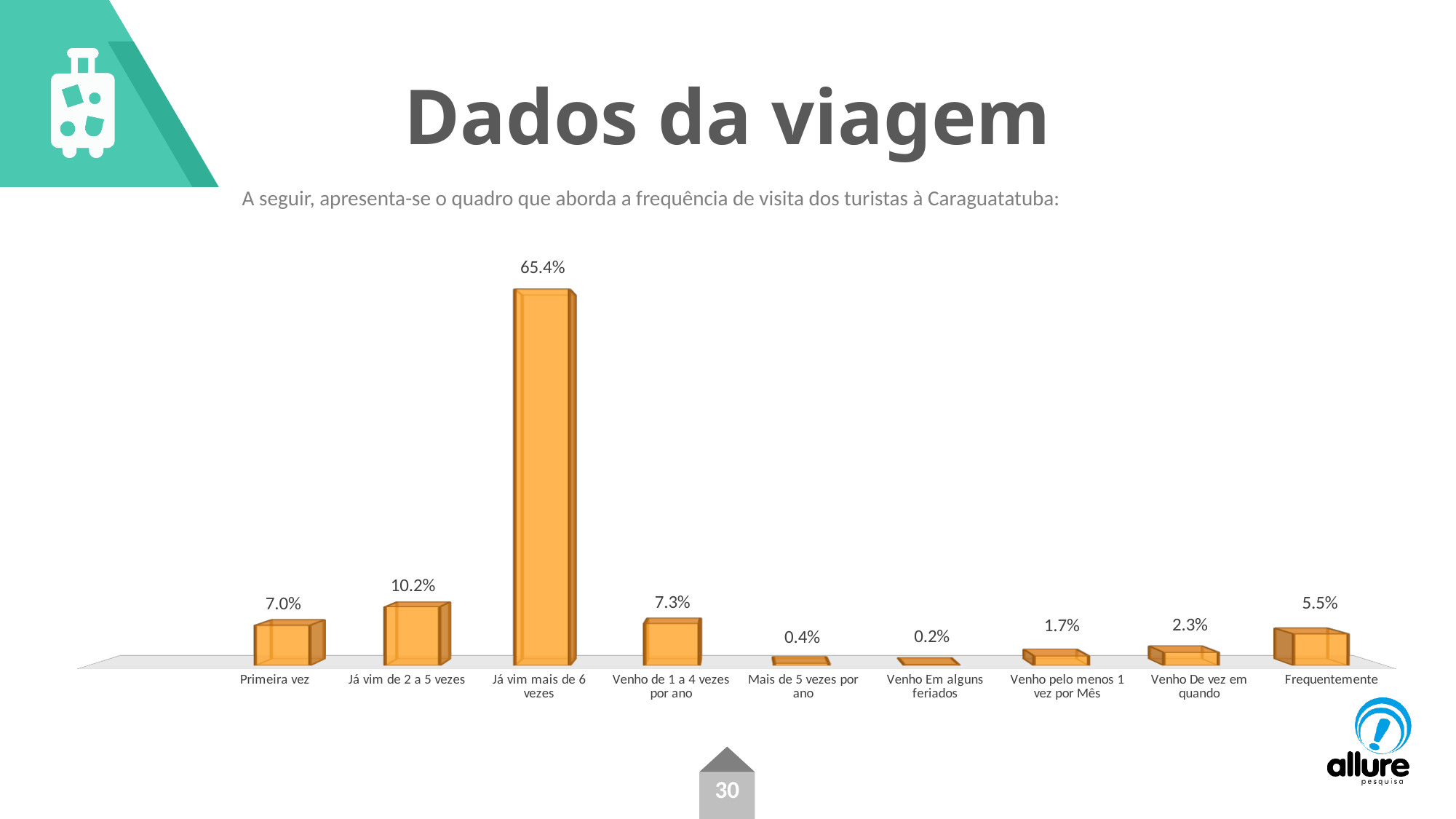
What is the difference between "Já vim de 2 a 5 vezes" and "Primeira vez"? 3.2% Which category has the lowest value? Venho Em alguns feriados What is the value for "Já vim mais de 6 vezes"? 65.4% Which category has the highest value? Já vim mais de 6 vezes What colour are the bars in the chart? Orange What is the value for "Frequentemente"? 5.5% Which is larger, "Venho de 1 a 4 vezes por ano" or "Frequentemente"? Venho de 1 a 4 vezes por ano What is the value for "Venho Em alguns feriados"? 0.2% How many categories are shown in the chart? 9 What is the value for "Primeira vez"? 7.0% What kind of chart is shown on the slide? Bar chart What is the difference between "Venho De vez em quando" and "Venho pelo menos 1 vez por Mês"? 0.6%